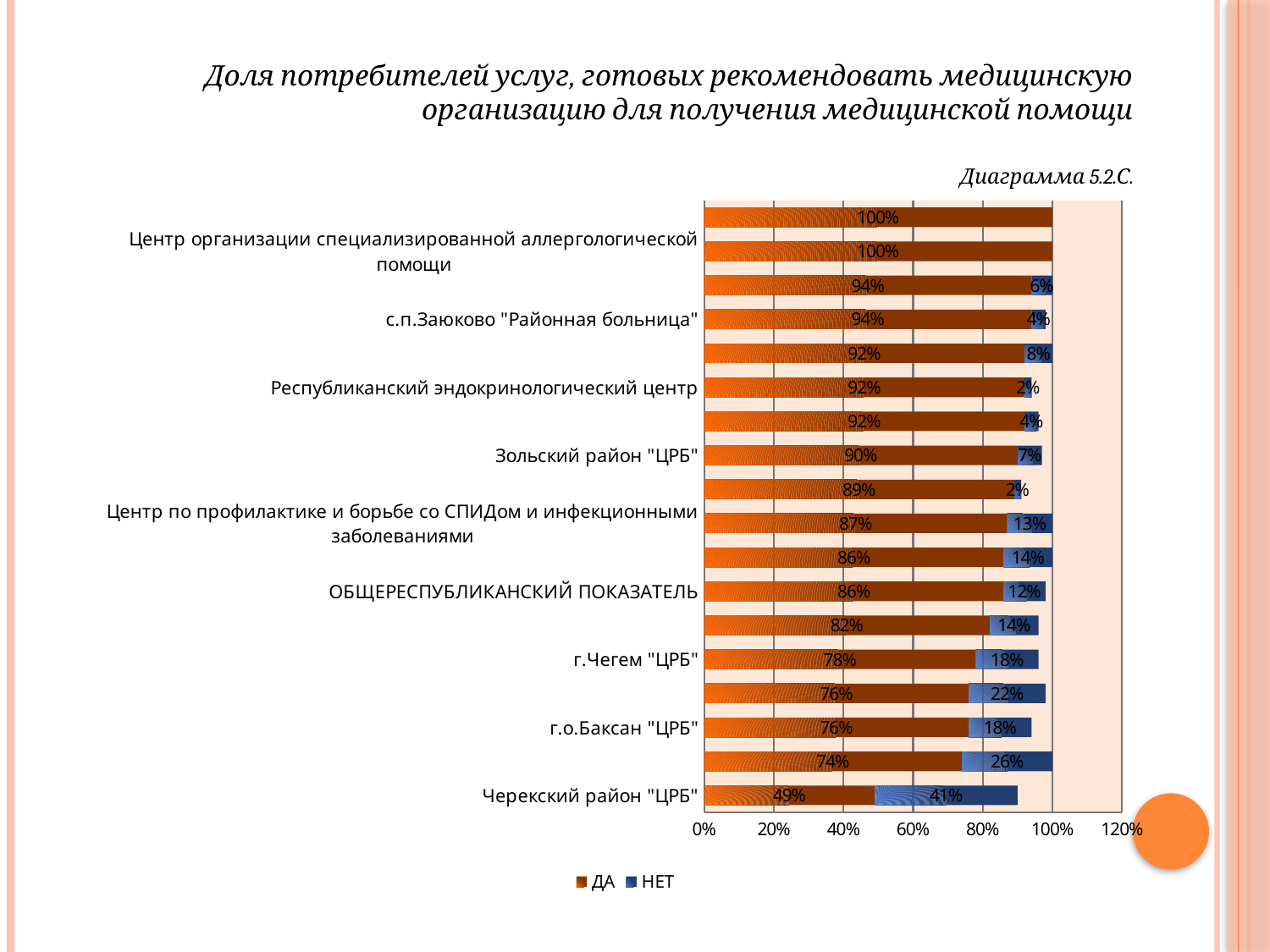
What is the НЕТ value for г.Чегем "ЦРБ"? 18% What is the ДА value for Черекский район "ЦРБ"? 49% How many series does the legend list? 2 What type of chart is shown on the slide? bar chart What are the two series named in the legend? ДА and НЕТ What is the ДА value for ОБЩЕРЕСПУБЛИКАНСКИЙ ПОКАЗАТЕЛЬ? 86% Which labelled category has the highest НЕТ value? Черекский район "ЦРБ" What is the НЕТ value for Черекский район "ЦРБ"? 41% Which has a larger ДА value: Зольский район "ЦРБ" or г.Чегем "ЦРБ"? Зольский район "ЦРБ" What is the ДА value for Зольский район "ЦРБ"? 90% Which labelled category has the lowest ДА value? Черекский район "ЦРБ" What is the difference between the ДА and НЕТ values for Черекский район "ЦРБ"? 8%